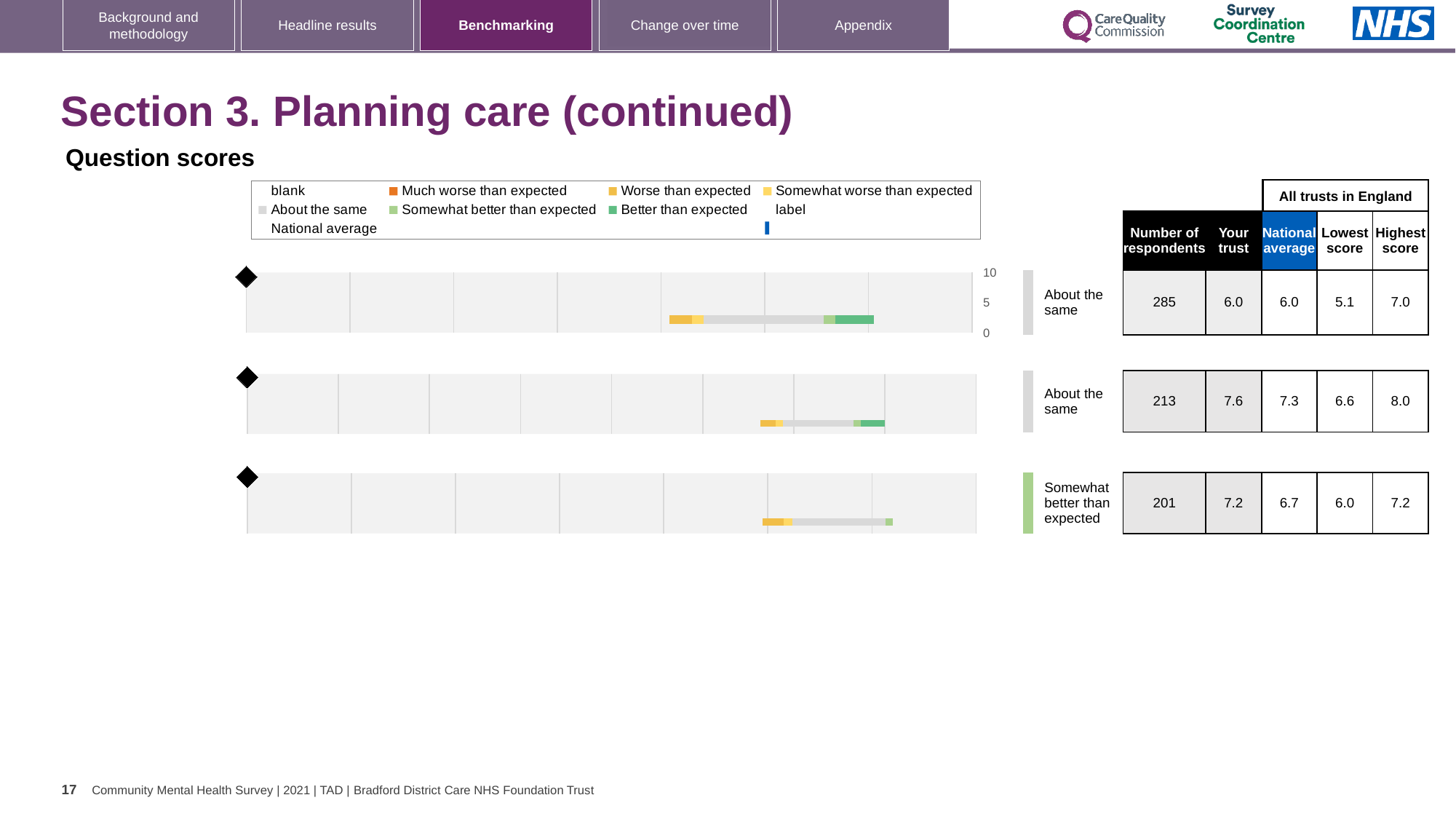
Which chart (top, middle or bottom) has the highest 'Your trust' score? middle What benchmark category is shown next to the bottom chart? Somewhat better than expected What colour does the legend use for 'Better than expected'? green How many question score charts are shown on the slide? 3 For the middle chart, which is larger: the 'Your trust' score or the national average? Your trust For the middle chart, what is the national average score? 7.3 For the bottom chart, what is the difference between the 'Your trust' score and the national average? 0.5 For the bottom chart, how many respondents are listed? 201 For the top chart, what is the 'Your trust' score shown in the table? 6.0 For the top chart, what is the difference between the highest score and the lowest score? 1.9 For the middle chart, what is the highest score among all trusts in England? 8.0 What kind of chart is used to show the question scores on this slide? bar chart